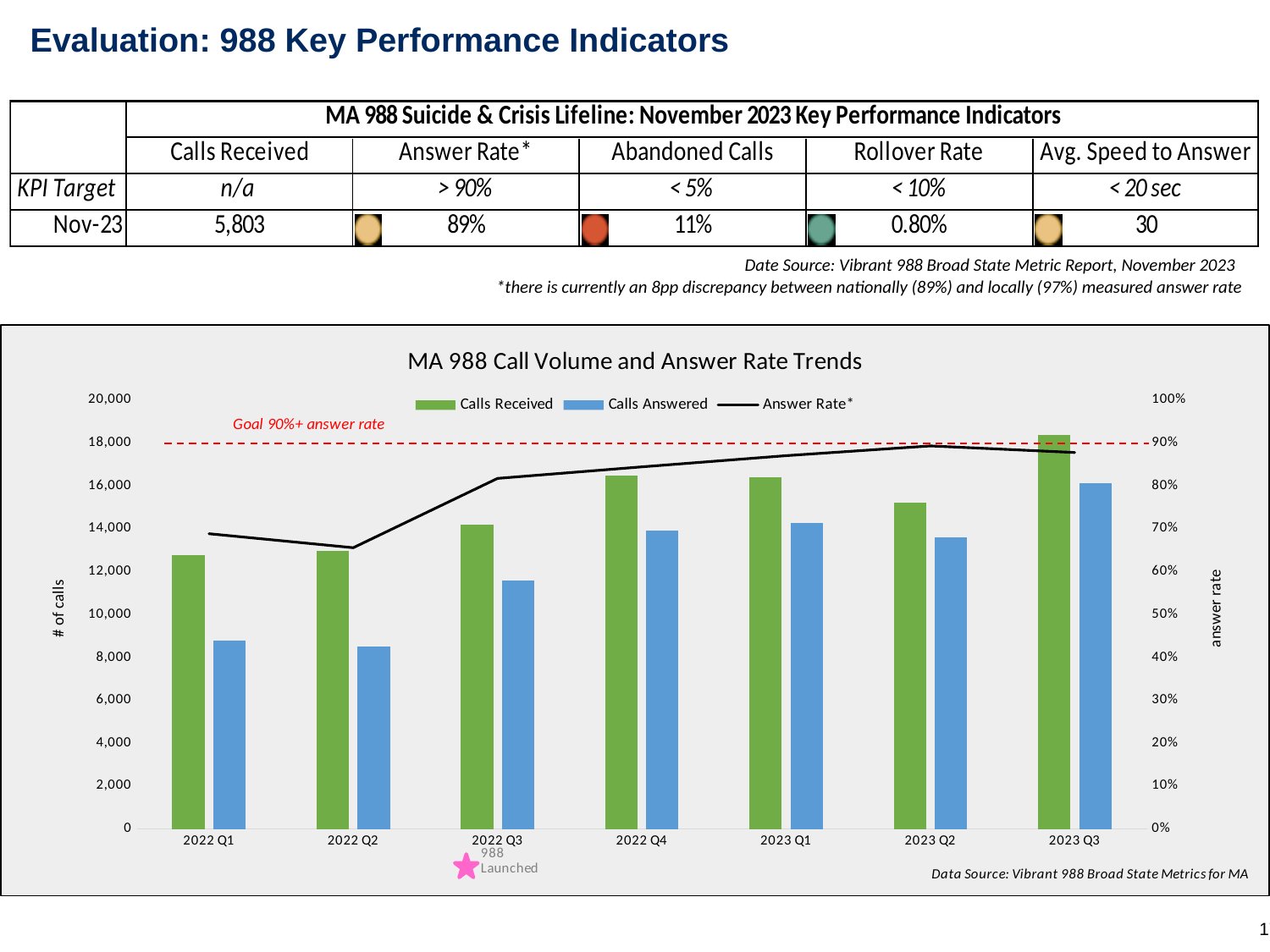
What answer rate goal does the red dashed line on the chart represent? Goal 90%+ answer rate Is the value for Calls Answered in 2022 Q1 greater or less than 10,000? less Is the value for Calls Received in 2022 Q4 greater or less than 16,000? greater Which quarter has the highest number of Calls Answered? 2023 Q3 What kind of chart is used for the Calls Received and Calls Answered series? Bar chart Is the Answer Rate in 2022 Q1 greater or less than 70%? less Which quarter has the highest number of Calls Received? 2023 Q3 Which is larger, Calls Received in 2022 Q4 or Calls Received in 2023 Q2? 2022 Q4 How many quarters are shown on the x axis of the chart? 7 What is the title of the chart on the slide? MA 988 Call Volume and Answer Rate Trends How many series does the chart legend list? 3